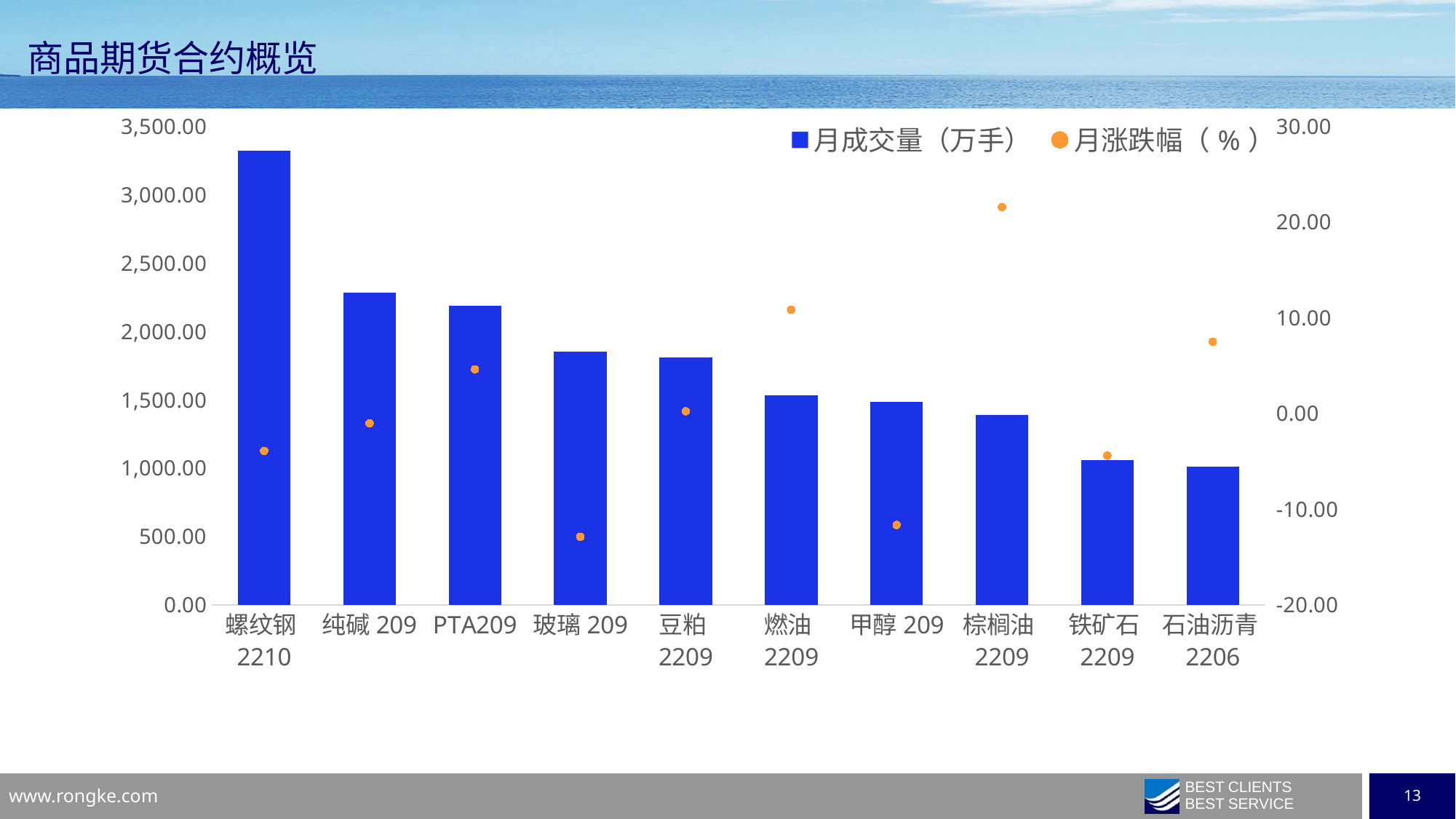
What kind of chart is this? Bar chart with dot markers on a secondary axis Which has the larger 月成交量（万手） bar, 纯碱 209 or 玻璃 209? 纯碱 209 Which contract has the highest 月涨跌幅（%） dot? 棕榈油 2209 How many series does the legend list? 2 Is the 月成交量（万手） value for 螺纹钢 2210 greater or less than 3,000.00? greater Is the 月涨跌幅（%） value for 棕榈油 2209 greater or less than 20.00? greater How many contracts are shown on the x axis? 10 Which contract has the highest 月成交量（万手） bar? 螺纹钢 2210 Is the 月涨跌幅（%） value for 玻璃 209 greater or less than -10.00? less Do the 月成交量（万手） bars rise or fall from left to right along the x axis? Fall Which contract has the lowest 月成交量（万手） bar? 石油沥青 2206